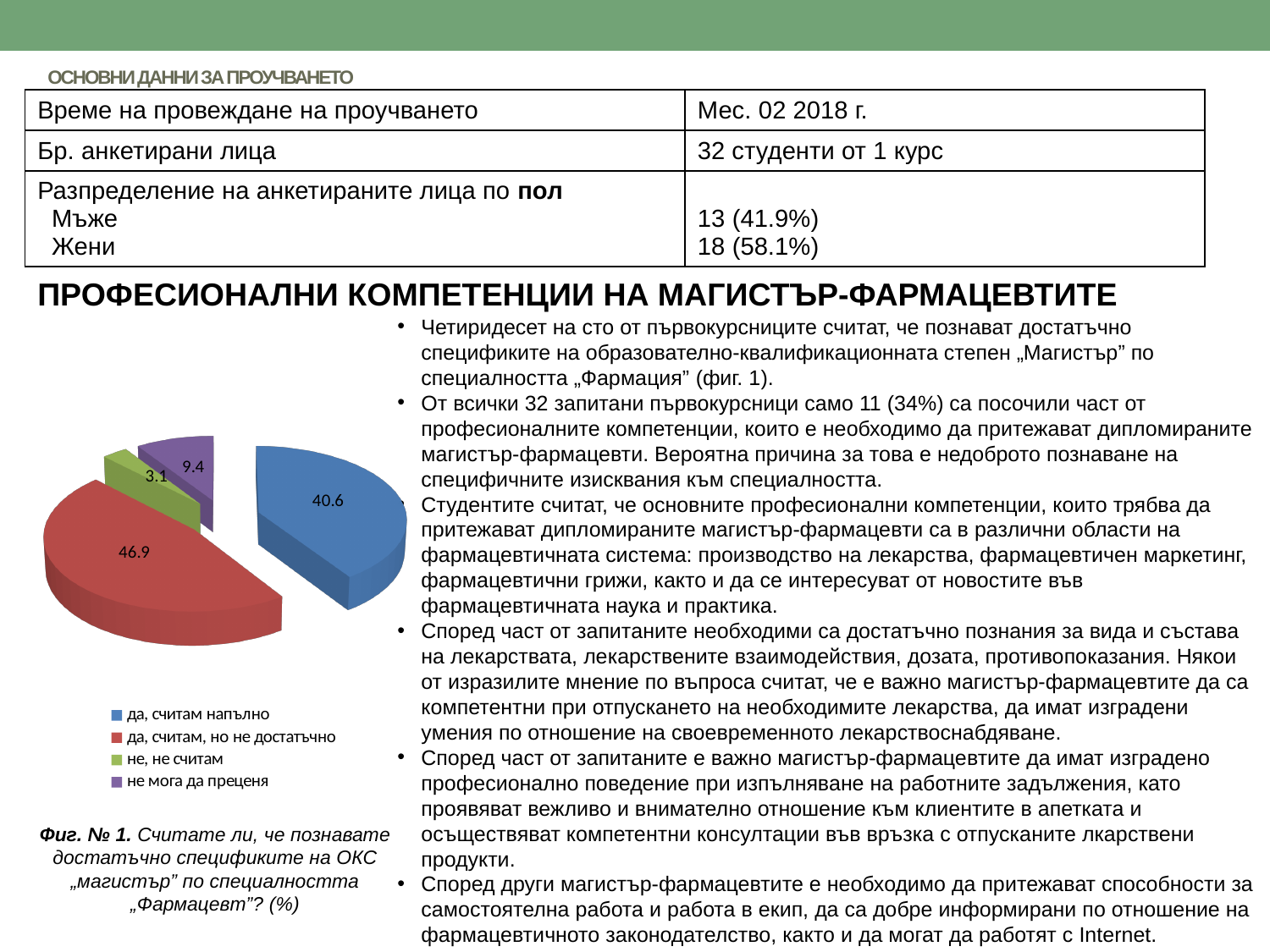
What kind of chart is shown on the slide? pie chart How many slices does the pie chart have? 4 What colour is the slice for "да, считам напълно" in the pie chart? blue How many entries does the legend of the pie chart list? 4 Which category has the largest slice in the pie chart? да, считам, но не достатъчно What is the value for "да, считам, но не достатъчно" in the pie chart? 46.9 What is the value for "да, считам напълно" in the pie chart? 40.6 Which category has the smallest slice in the pie chart? не, не считам What is the difference between the values for "да, считам, но не достатъчно" and "да, считам напълно"? 6.3 What is the value for "не, не считам" in the pie chart? 3.1 What is the value for "не мога да преценя" in the pie chart? 9.4 Which is larger: the value for "не мога да преценя" or the value for "не, не считам"? не мога да преценя